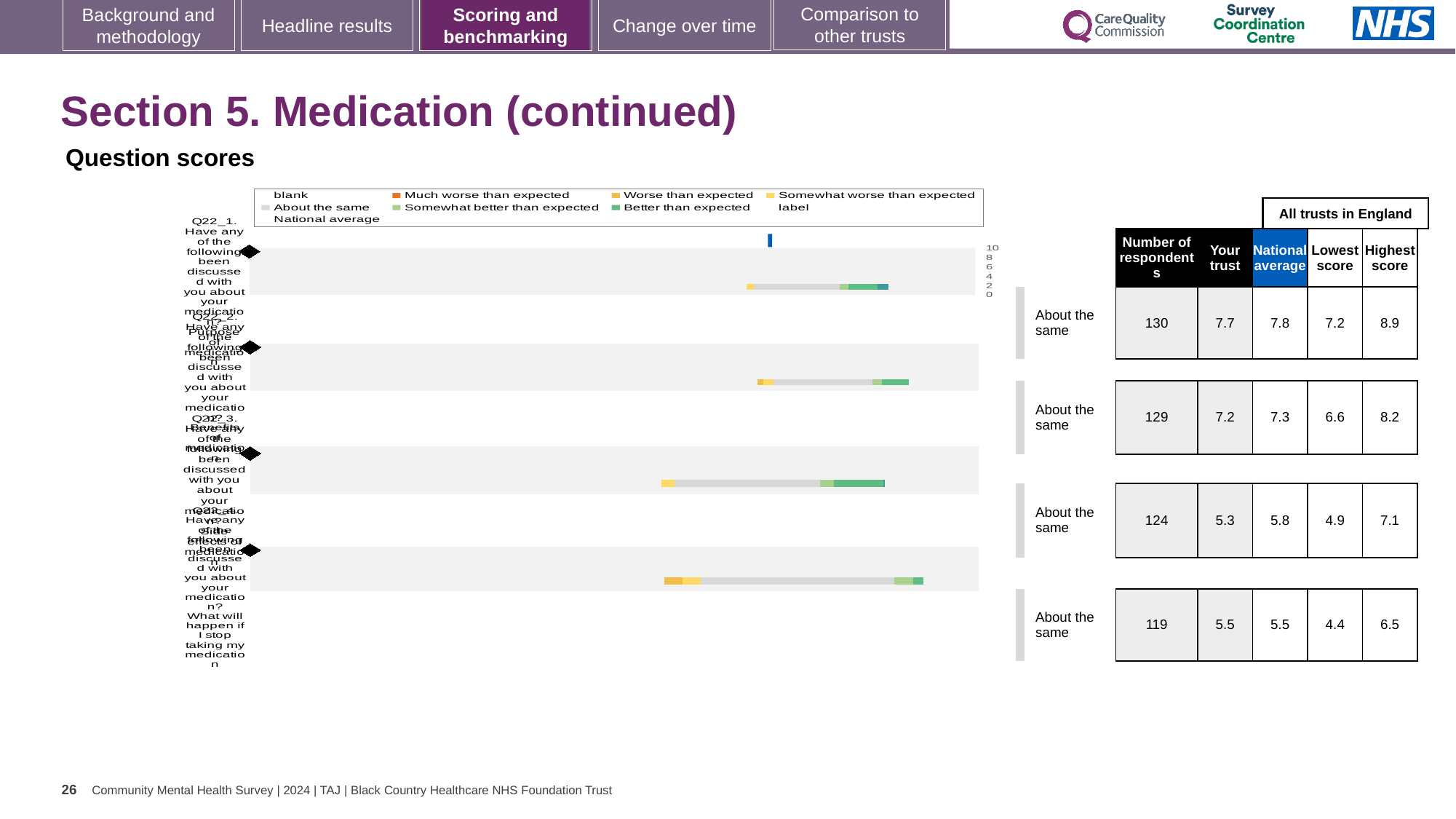
What kind of chart is shown under 'Question scores'? bar chart How many entries does the legend of the 'Question scores' chart list? 9 Which row of the table has the highest 'Your trust' score? the top row (Q22_1), 7.7 In the table beside the chart, what is the 'National average' for the second row (Q22_2)? 7.3 Which row of the table has the lowest 'Number of respondents'? the bottom row (Q22_4), 119 What heading appears above the 'Lowest score' and 'Highest score' columns of the table? All trusts in England In the table beside the chart, what is the 'Your trust' score for the top row (Q22_1)? 7.7 In the table beside the chart, what is the 'Number of respondents' for the third row (Q22_3)? 124 For the top row (Q22_1), what is the difference between the 'Highest score' and the 'Lowest score'? 1.7 How many question bars are plotted in the 'Question scores' chart? 4 What benchmark category is shown next to each of the four question bars? About the same For the third row (Q22_3), which is larger: the 'Your trust' score or the 'National average'? National average